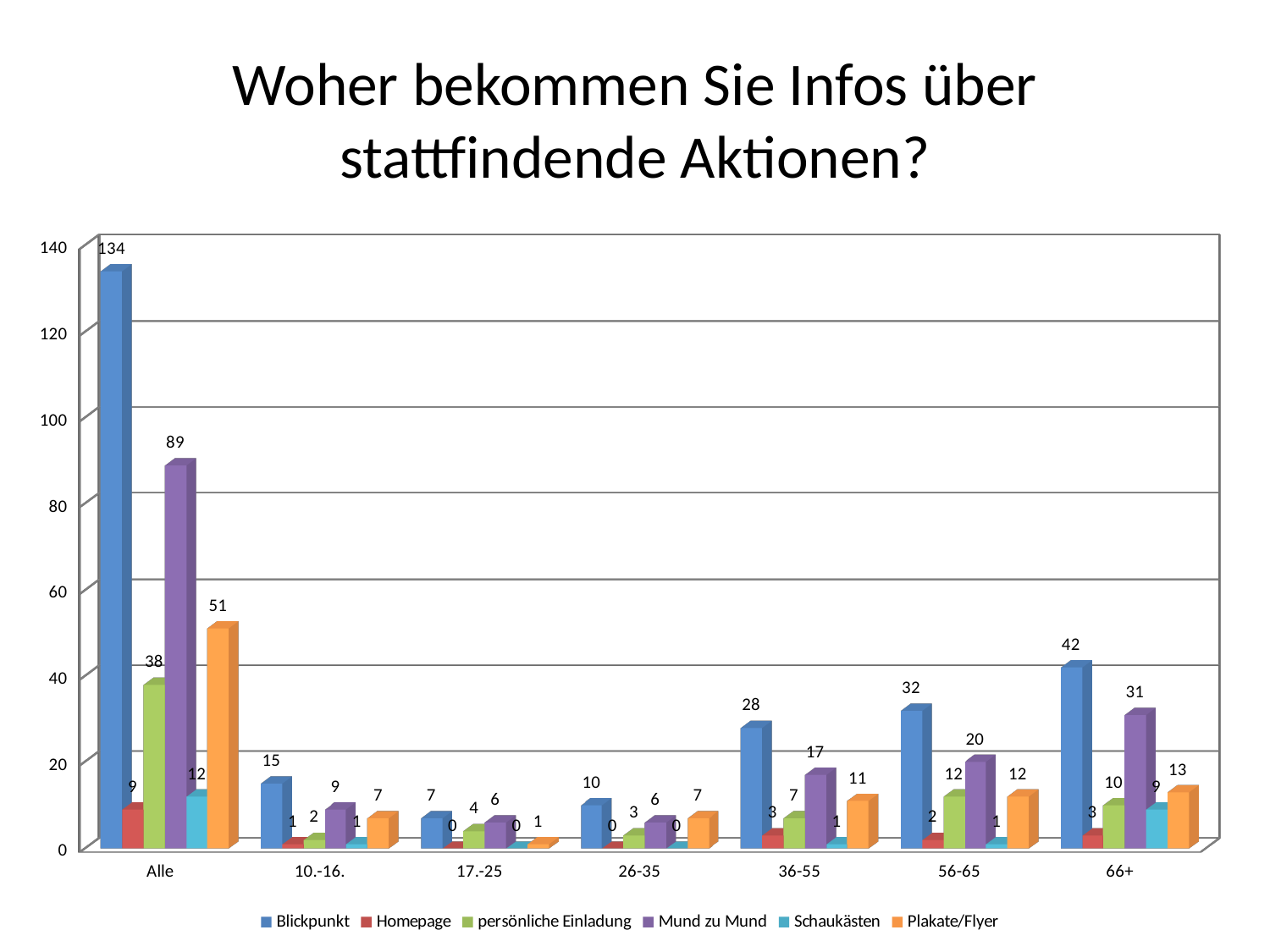
What is the title of the chart? Woher bekommen Sie Infos über stattfindende Aktionen? What is the value for Blickpunkt in the Alle category? 134 What is the value for Mund zu Mund in the 66+ category? 31 How many series does the legend list? 6 Is the value for Plakate/Flyer in the Alle category greater or less than 40? greater How many categories are shown on the x axis? 7 What is the value for Plakate/Flyer in the 36-55 category? 11 Which age category has the highest value for Blickpunkt, excluding Alle? 66+ What kind of chart is shown on the slide? Bar chart Which series has the lowest value in the Alle category? Homepage What is the difference between Blickpunkt and Mund zu Mund in the Alle category? 45 Which is larger in the 56-65 category: Blickpunkt or Mund zu Mund? Blickpunkt